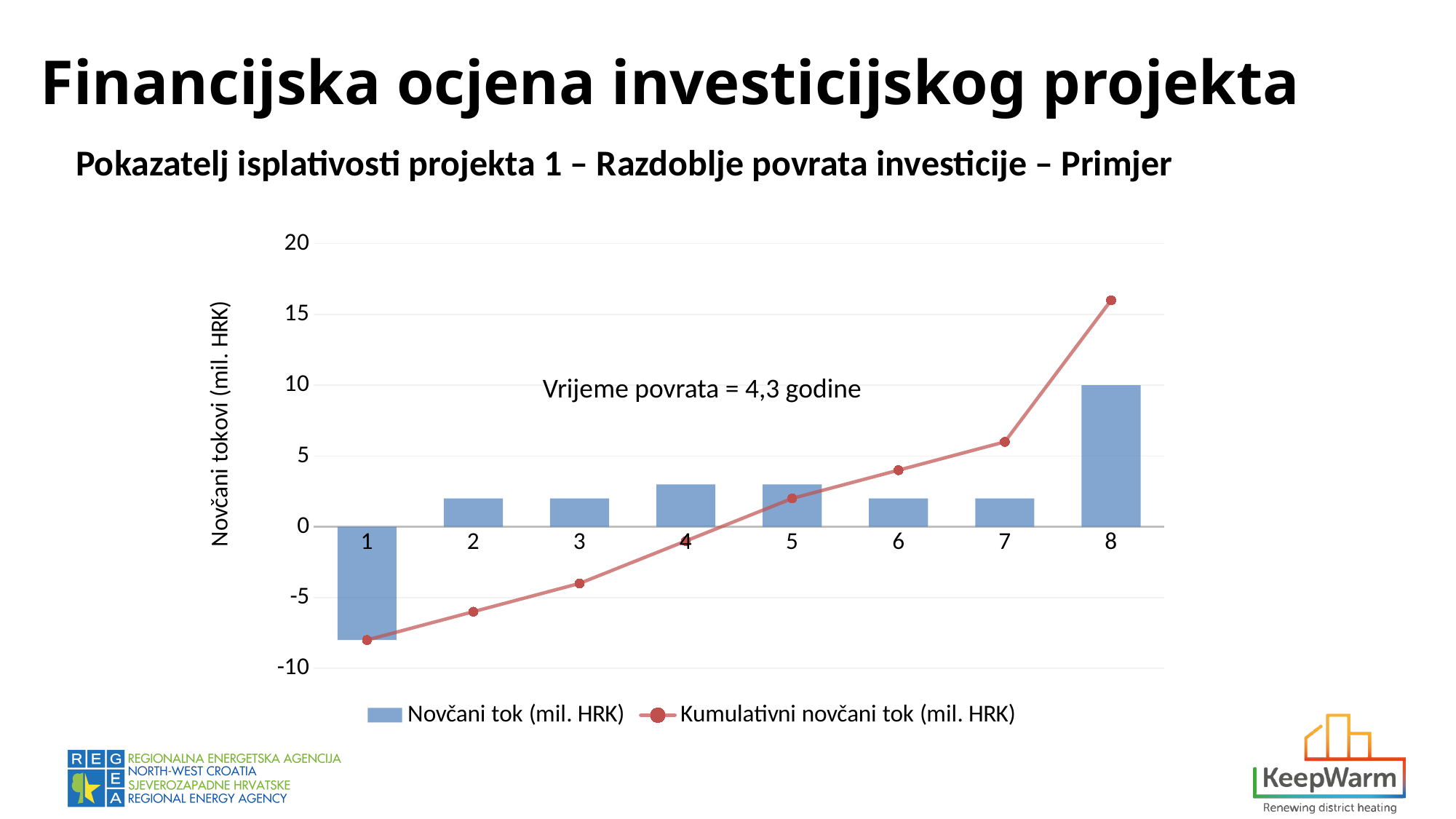
How many periods (categories) are shown on the x axis? 8 Is the Novčani tok (mil. HRK) value for period 1 greater or less than -5? less Does the Kumulativni novčani tok (mil. HRK) line rise or fall from period 1 to period 8? It rises In which period is the bar for Novčani tok (mil. HRK) the lowest? 1 Is the Novčani tok (mil. HRK) value for period 8 greater or less than 5? greater Is the Kumulativni novčani tok (mil. HRK) value for period 2 greater or less than -5? less What payback time is stated in the annotation on the chart? Vrijeme povrata = 4,3 godine In which period is the bar for Novčani tok (mil. HRK) the highest? 8 Which is larger, the Novčani tok (mil. HRK) bar for period 8 or for period 4? Period 8 How many series does the legend list? 2 What kind of chart is shown on the slide? A combined bar and line chart